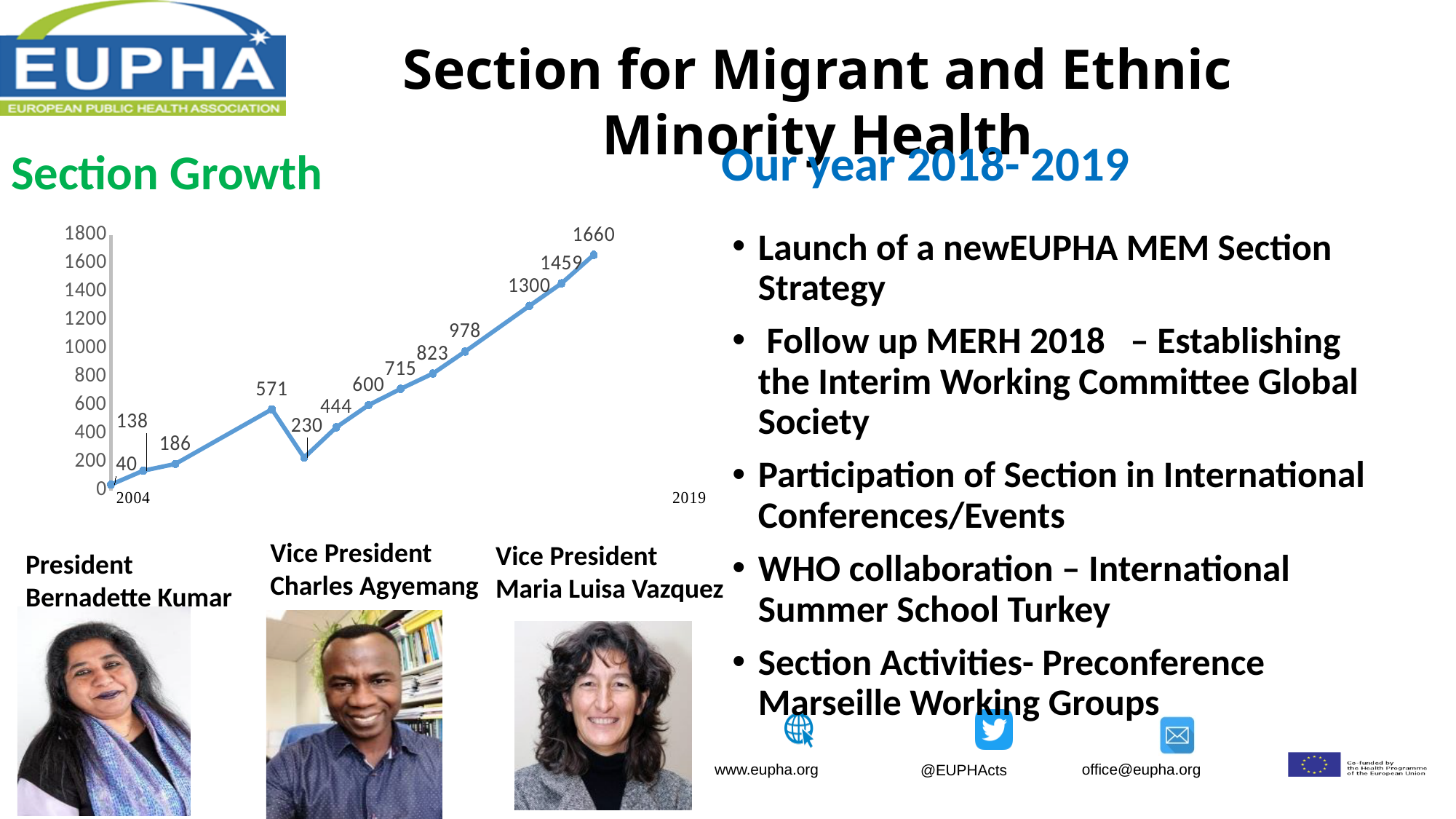
What is the value of the data point labelled just before 1660 on the Section Growth chart? 1459 On the Section Growth chart, how much does the value drop from the 571 peak to the following point labelled 230? 341 What are the first and last years shown on the x axis of the Section Growth chart? 2004 and 2019 On the Section Growth chart, which is larger: the point labelled 571 or the point labelled 444? 571 What is the difference between the last two labelled values, 1660 and 1459, on the Section Growth chart? 201 What is the title of the chart on the slide? Section Growth What is the lowest value labelled on the Section Growth chart? 40 What is the highest value labelled on the Section Growth chart? 1660 What is the difference between the values labelled 1300 and 978 on the Section Growth chart? 322 What kind of chart is the Section Growth chart? line chart What is the value of the last data point on the Section Growth chart? 1660 Overall, do the values on the Section Growth chart rise or fall from 2004 to 2019? rise